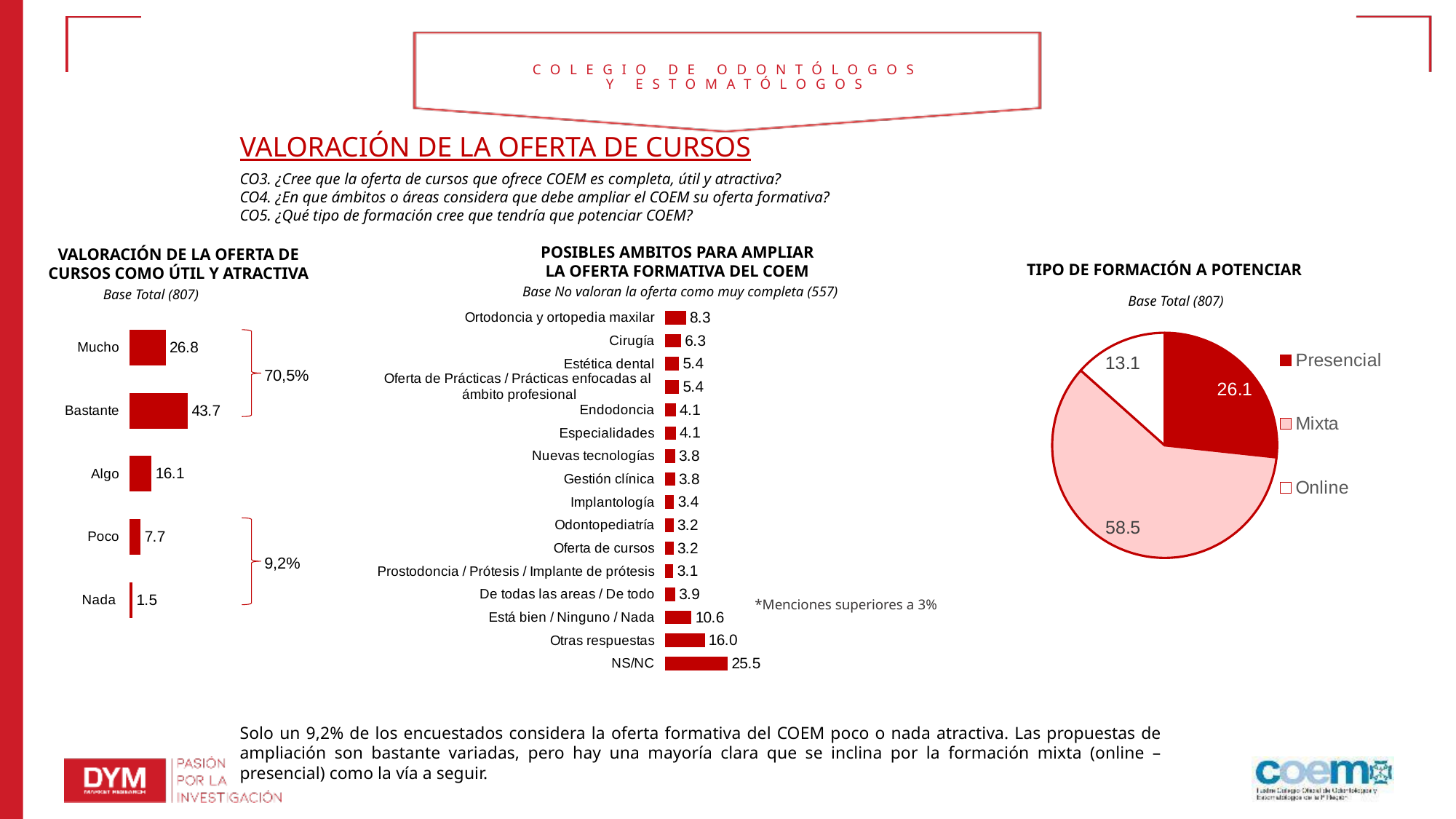
In the chart 'VALORACIÓN DE LA OFERTA DE CURSOS COMO ÚTIL Y ATRACTIVA', what is the difference between 'Mucho' and 'Algo'? 10.7 In the chart 'POSIBLES AMBITOS PARA AMPLIAR LA OFERTA FORMATIVA DEL COEM', which is larger: 'Ortodoncia y ortopedia maxilar' or 'Está bien / Ninguno / Nada'? Está bien / Ninguno / Nada In the pie chart 'TIPO DE FORMACIÓN A POTENCIAR', which category has the smallest slice? Online In the chart 'POSIBLES AMBITOS PARA AMPLIAR LA OFERTA FORMATIVA DEL COEM', which category has the highest value? NS/NC How many categories are shown in the chart 'VALORACIÓN DE LA OFERTA DE CURSOS COMO ÚTIL Y ATRACTIVA'? 5 In the chart 'POSIBLES AMBITOS PARA AMPLIAR LA OFERTA FORMATIVA DEL COEM', what is the value for 'Otras respuestas'? 16.0 How many entries does the legend of the pie chart 'TIPO DE FORMACIÓN A POTENCIAR' list? 3 In the chart 'VALORACIÓN DE LA OFERTA DE CURSOS COMO ÚTIL Y ATRACTIVA', which category has the lowest value? Nada In the pie chart 'TIPO DE FORMACIÓN A POTENCIAR', what is the value for 'Mixta'? 58.5 In the chart 'VALORACIÓN DE LA OFERTA DE CURSOS COMO ÚTIL Y ATRACTIVA', what is the value for 'Bastante'? 43.7 What type of chart is 'TIPO DE FORMACIÓN A POTENCIAR'? Pie chart In the chart 'POSIBLES AMBITOS PARA AMPLIAR LA OFERTA FORMATIVA DEL COEM', what is the value for 'Cirugía'? 6.3